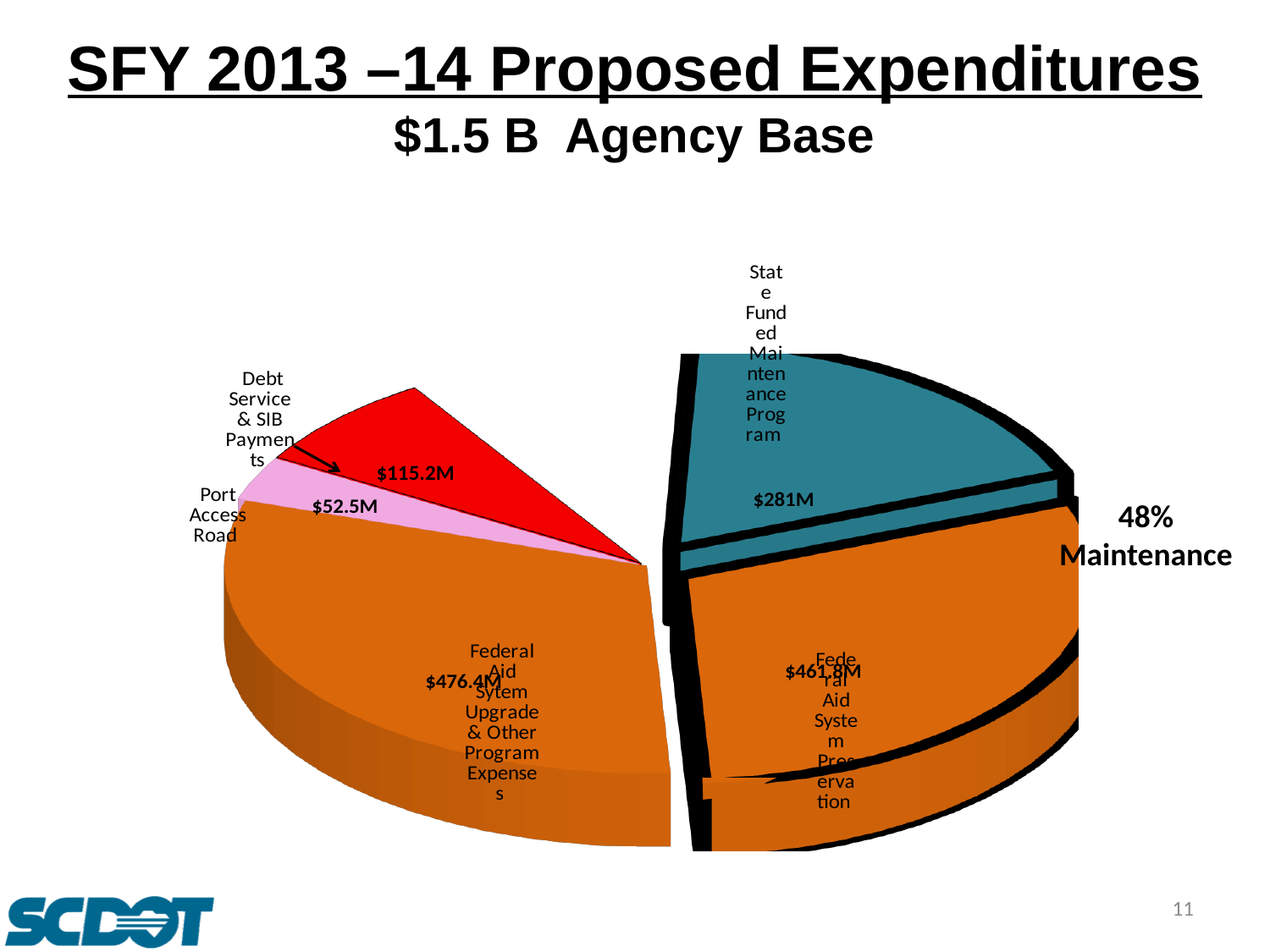
What is the value of the Port Access Road slice? $52.5M What is the value of the Debt Service & SIB Payments slice? $115.2M What is the difference between the Debt Service & SIB Payments slice and the Port Access Road slice? $62.7M What is the difference between the Federal Aid System Upgrade & Other Program Expenses slice and the Federal Aid System Preservation slice? $14.6M What is the value of the Federal Aid System Upgrade & Other Program Expenses slice? $476.4M What is the value of the Federal Aid System Preservation slice? $461.8M Which slice has the largest value? Federal Aid System Upgrade & Other Program Expenses What is the value of the State Funded Maintenance Program slice? $281M Which is larger, the State Funded Maintenance Program slice or the Debt Service & SIB Payments slice? State Funded Maintenance Program What type of chart is shown on the slide? pie chart